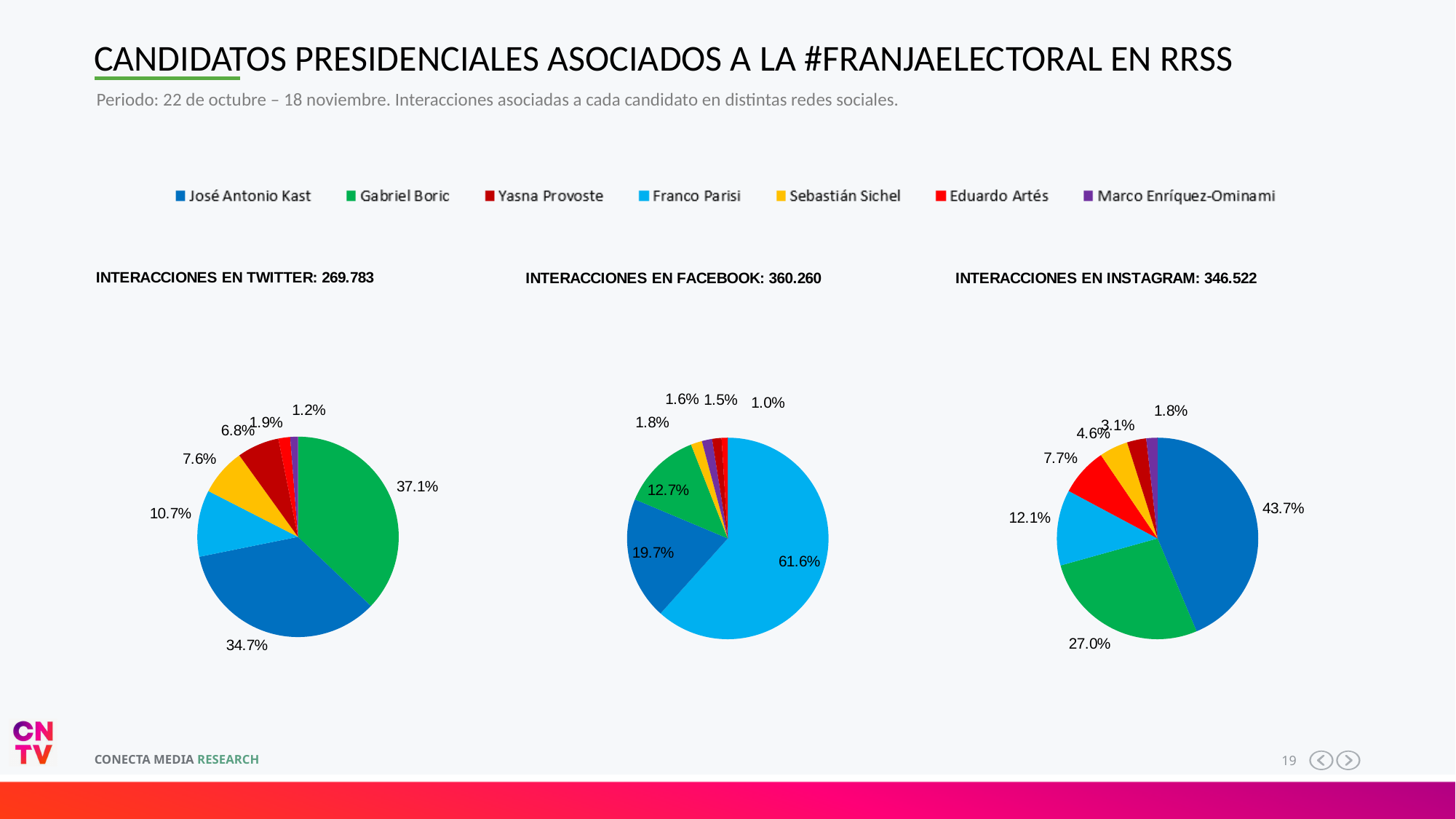
What kind of charts are shown on the slide? Pie charts In the Twitter pie chart, who has the larger share, Franco Parisi or Sebastián Sichel? Franco Parisi In the Facebook pie chart, what share does Franco Parisi have? 61.6% In the Instagram pie chart, which candidate has the smallest share? Marco Enríquez-Ominami In the Instagram pie chart, what is the difference between the shares of José Antonio Kast and Gabriel Boric? 16.7% In the Facebook pie chart (INTERACCIONES EN FACEBOOK), which candidate has the largest share? Franco Parisi In the Instagram pie chart (INTERACCIONES EN INSTAGRAM), what share does José Antonio Kast have? 43.7% What total number of interactions is given for Facebook in the title of the middle chart? 360.260 In the Twitter pie chart, what share does José Antonio Kast have? 34.7% How many candidates does the legend list? 7